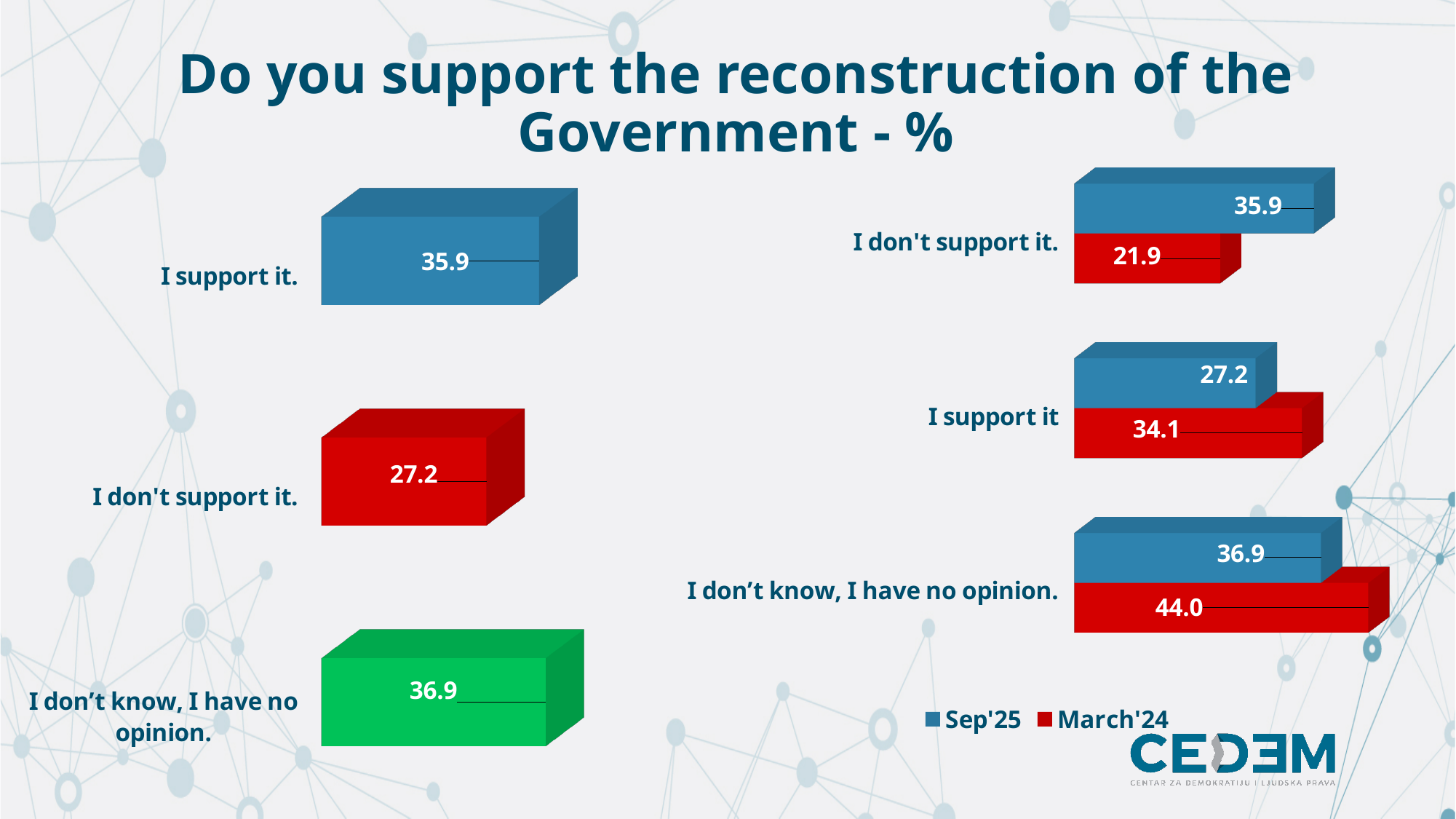
In the left chart, which category has the highest value? I don't know, I have no opinion. In the left chart, which category has the lowest value? I don't support it. In the right chart, what is the Sep'25 value for "I don't know, I have no opinion."? 36.9 In the right chart, what is the difference between the March'24 and Sep'25 values for "I don't know, I have no opinion."? 7.1 What type of chart is the right chart? Bar chart In the right chart, what is the March'24 value for "I don't support it."? 21.9 In the left chart, what is the difference between the values for "I don't know, I have no opinion." and "I don't support it."? 9.7 How many series does the legend of the right chart list? 2 In the left chart, how many categories are shown? 3 In the left chart, what is the value for "I support it."? 35.9 In the left chart, what is the value for "I don't support it."? 27.2 In the right chart, which is larger for "I support it": the Sep'25 value or the March'24 value? March'24